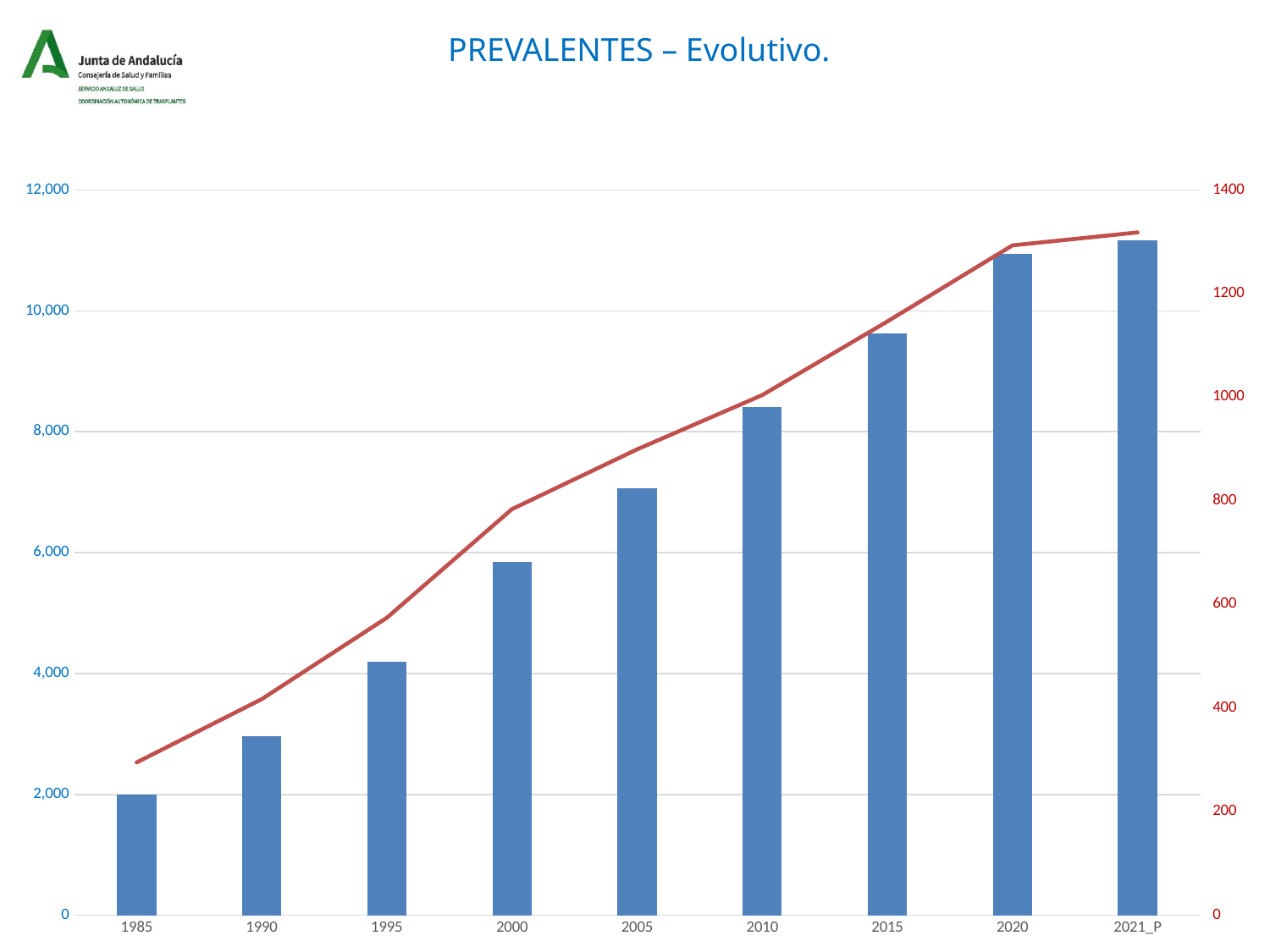
Which year has the shortest bar? 1985 Do the bar values rise or fall from 1985 to 2021_P? rise On the right-hand axis, is the red line value for 1985 greater or less than 400? less Is the bar value for 2010 greater or less than 8,000? greater What is the title of the chart? PREVALENTES – Evolutivo. How many years are shown along the x axis? 9 What kind of chart is shown on the slide? A bar chart combined with a line Is the bar value for 2015 greater or less than 10,000? less Which year has the tallest bar? 2021_P Which bar is taller, 1995 or 2005? 2005